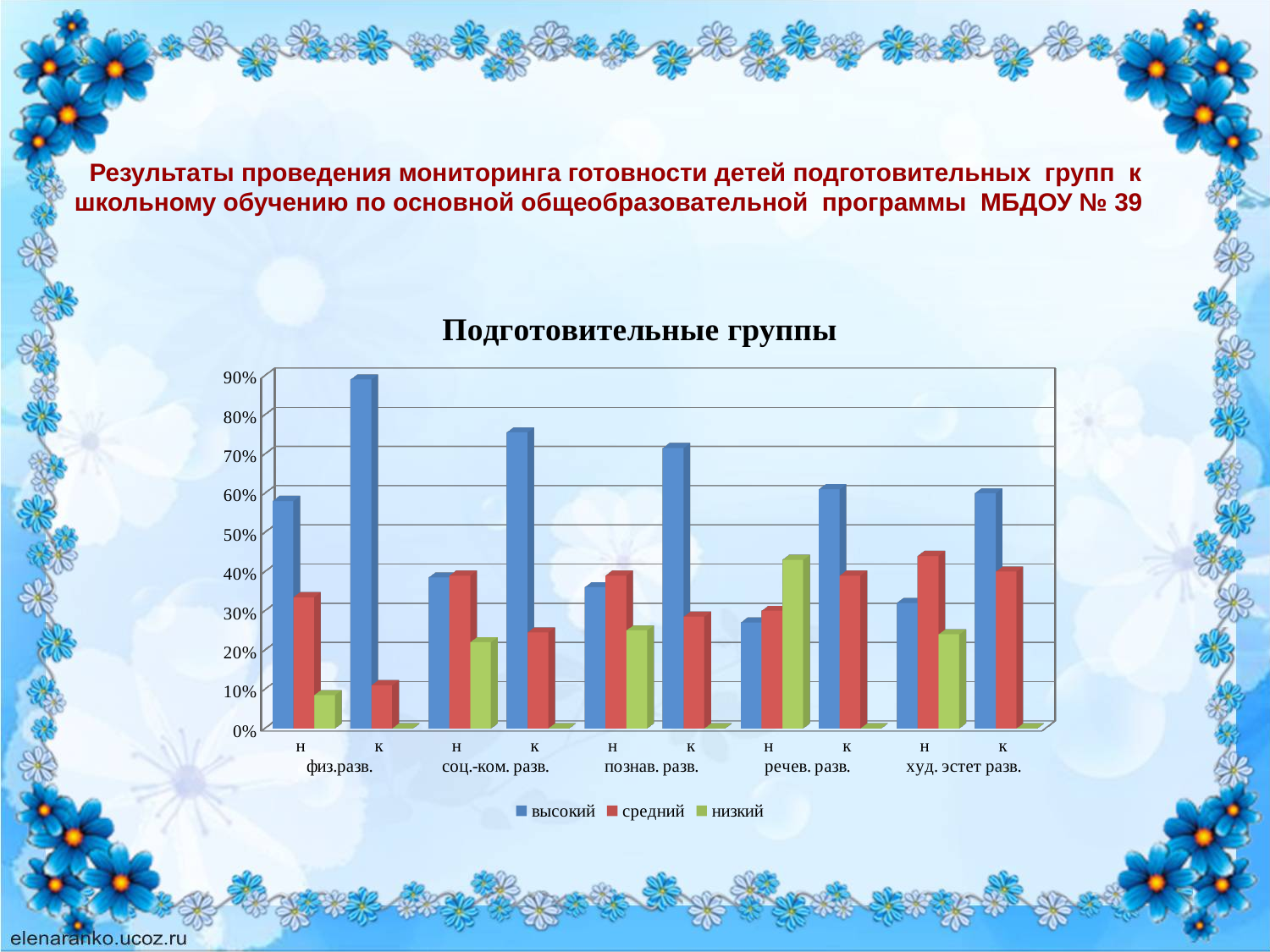
Is the высокий value for физ.разв. к greater or less than 80%? greater What kind of chart is shown on the slide? bar chart What are the three series named in the legend? высокий, средний, низкий What is the title of the chart? Подготовительные группы For познав. разв., does the высокий value rise or fall from н to к? rises Among the н groups, which area has the lowest низкий value? физ.разв. How many series does the legend list? 3 How many developmental areas are labelled along the x axis? 5 For физ.разв. н, which is larger: высокий or средний? высокий Which bar group has the highest высокий value? физ.разв. к Is the низкий value for речев. разв. н greater or less than 40%? greater For речев. разв. н, which is larger: высокий or низкий? низкий